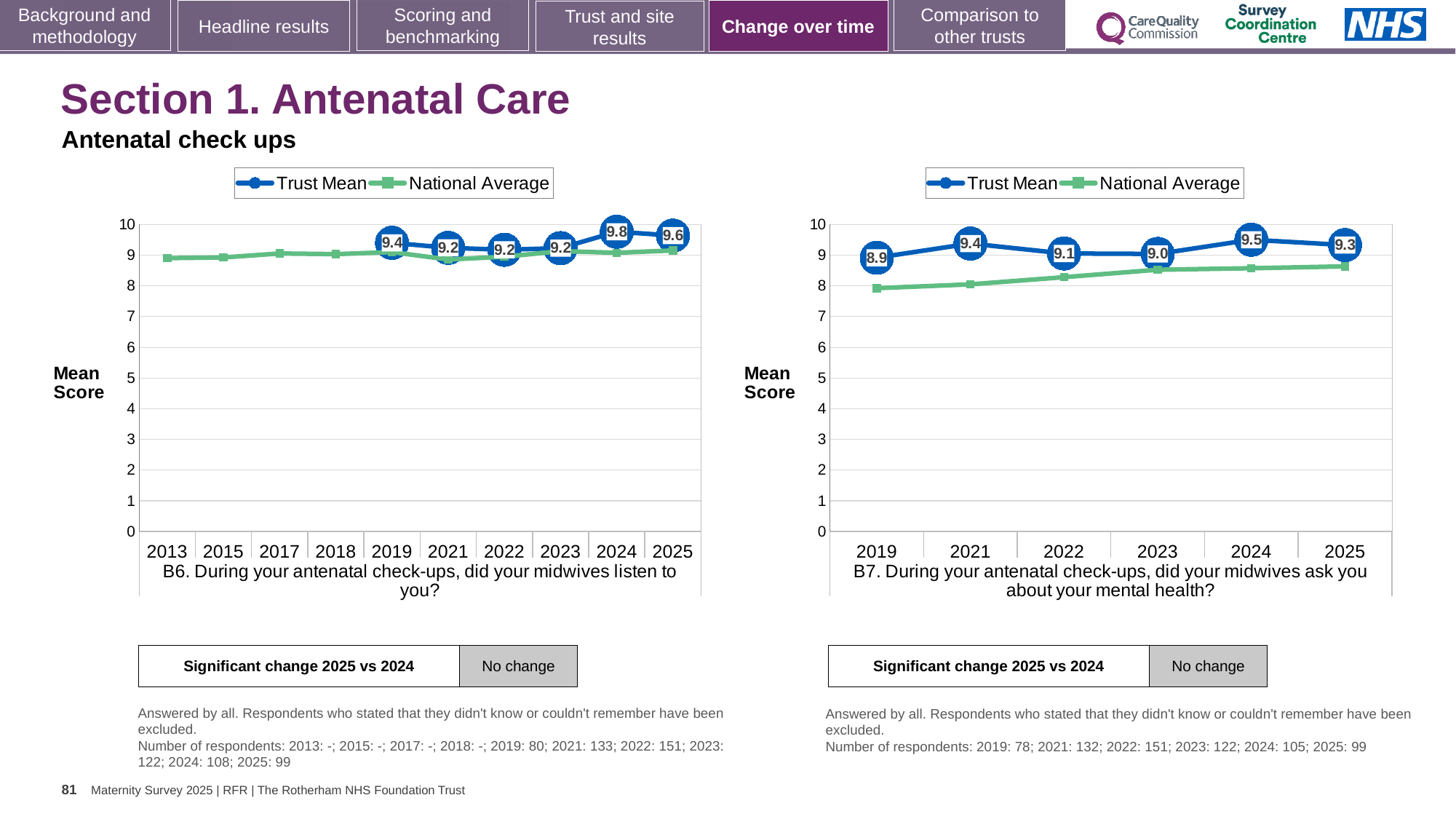
In the B6 chart (left), which year has the highest Trust Mean? 2024 How many years are shown on the x axis of the B7 chart (right)? 6 How many series does the legend of the B6 chart (left) list? 2 In the B6 chart (left), is the Trust Mean for 2024 or 2025 higher? 2024 In the B7 chart (right), which year has the lowest Trust Mean? 2019 In the B7 chart (right), what is the Trust Mean for 2024? 9.5 In the B6 chart (left), what is the Trust Mean for 2024? 9.8 In the B6 chart (left), what is the Trust Mean for 2025? 9.6 In the B7 chart (right), what is the difference between the Trust Mean for 2024 and 2019? 0.6 What type of chart is the B6 chart (left)? Line chart In the B7 chart (right), what is the Trust Mean for 2019? 8.9